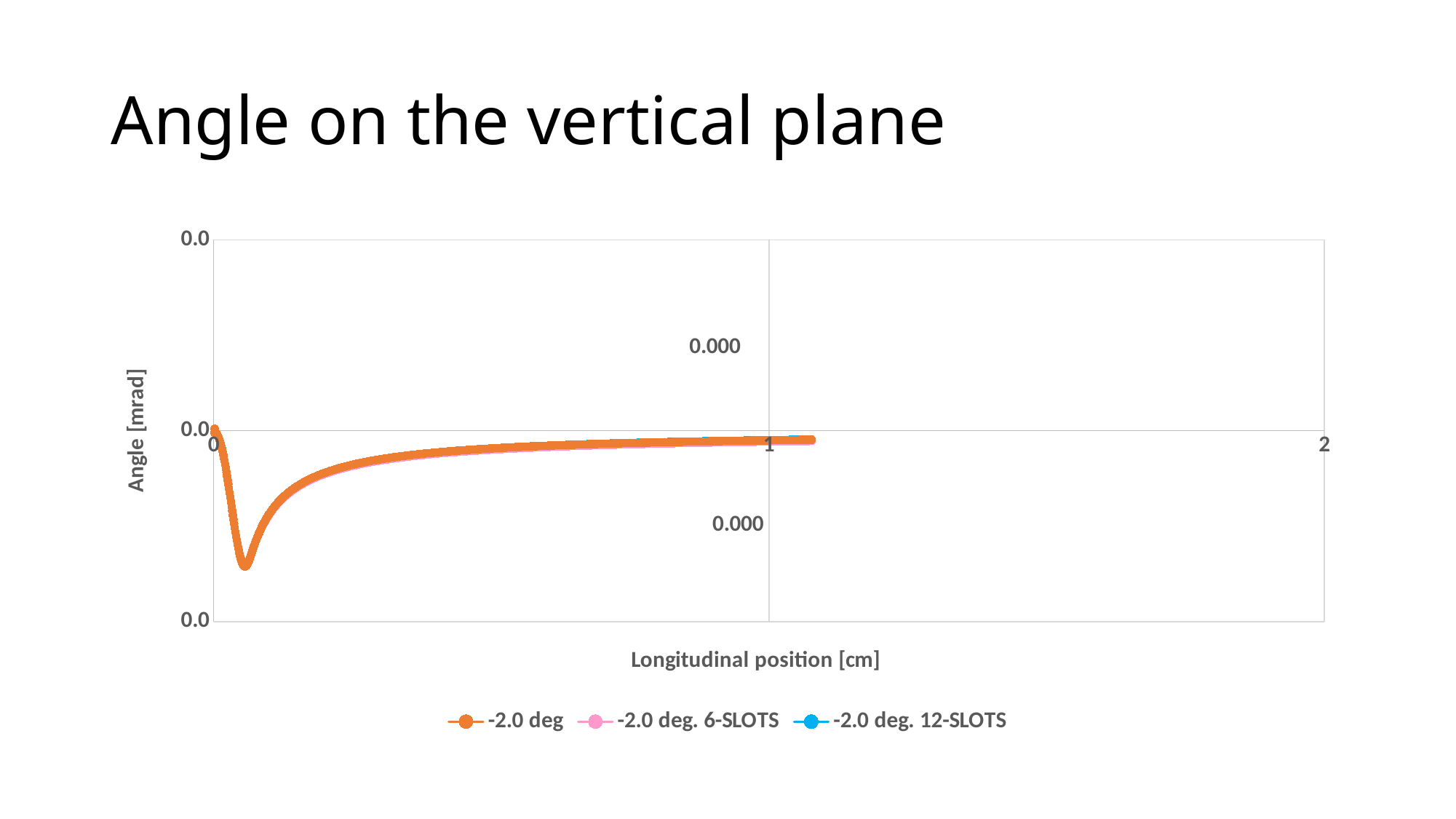
How many series does the legend list? 3 Which series is drawn in orange according to the legend? -2.0 deg What is the label of the x axis? Longitudinal position [cm] Does the plotted curve reach its lowest point near the start or near the end of the x axis? near the start What is the title of the chart on the slide? Angle on the vertical plane What is the label of the y axis? Angle [mrad] After its sharp dip near the start of the x axis, does the plotted curve rise or fall as the longitudinal position increases? rise What kind of chart is shown on the slide? line chart Do the three plotted series follow nearly the same curve or clearly different curves? nearly the same curve What is the largest tick value shown on the x axis? 2